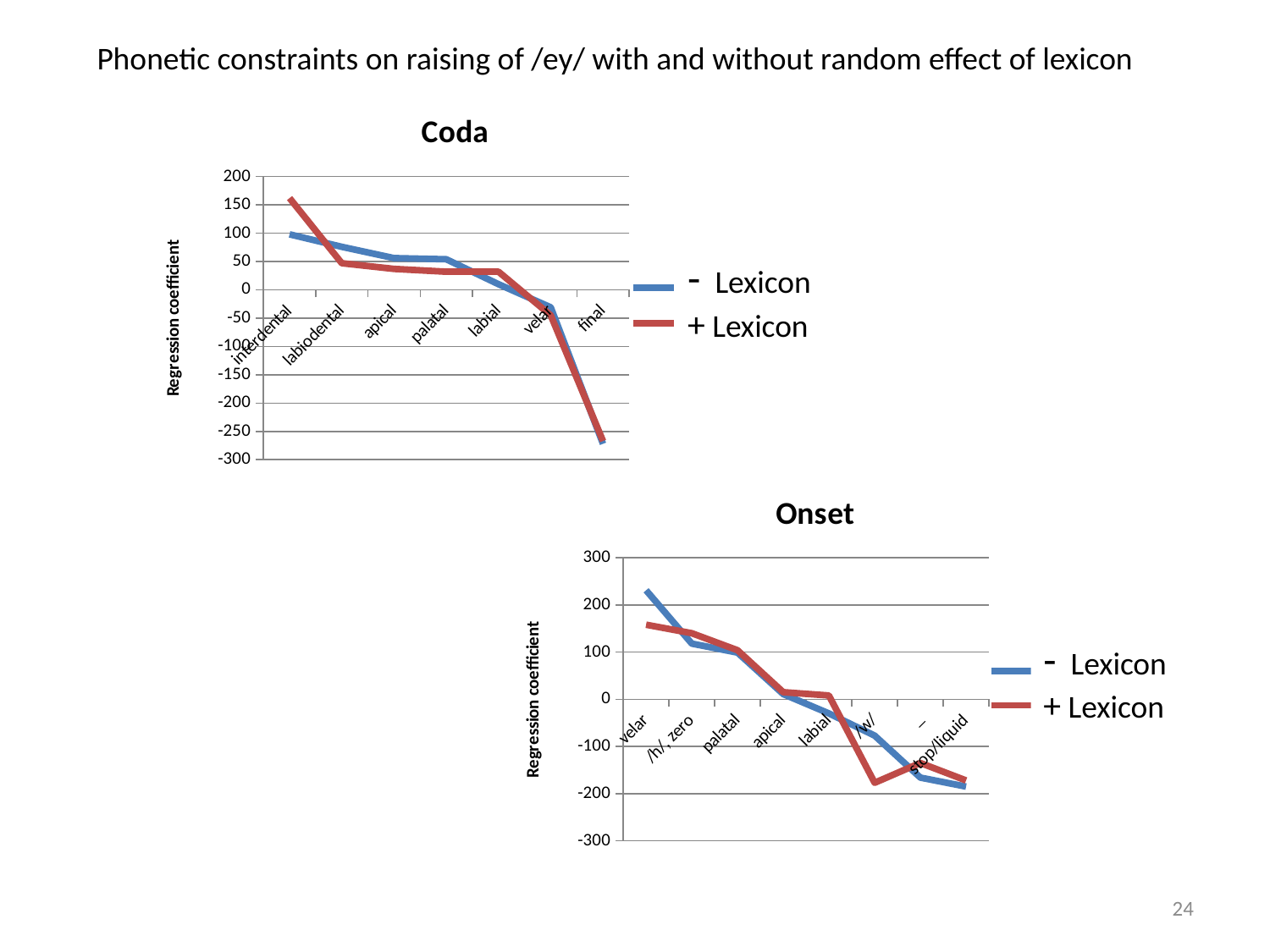
In the Onset chart, which category has the highest value for the - Lexicon series? velar How many categories are shown on the x axis of the Onset chart? 8 What kind of chart is the Coda chart? line chart In the Coda chart, which category has the lowest value for the - Lexicon series? final In the Onset chart, do the values generally rise or fall from velar to stop/liquid? fall In the Coda chart, at interdental, which series has the larger value, - Lexicon or + Lexicon? + Lexicon In the Coda chart, is the + Lexicon value for interdental greater or less than 100? greater In the Onset chart, is the - Lexicon value for velar greater or less than 200? greater In the Coda chart, which category has the highest value for the + Lexicon series? interdental In the Onset chart, which category has the lowest value for the - Lexicon series? stop/liquid How many series does the legend of the Onset chart list? 2 How many categories are shown on the x axis of the Coda chart? 7